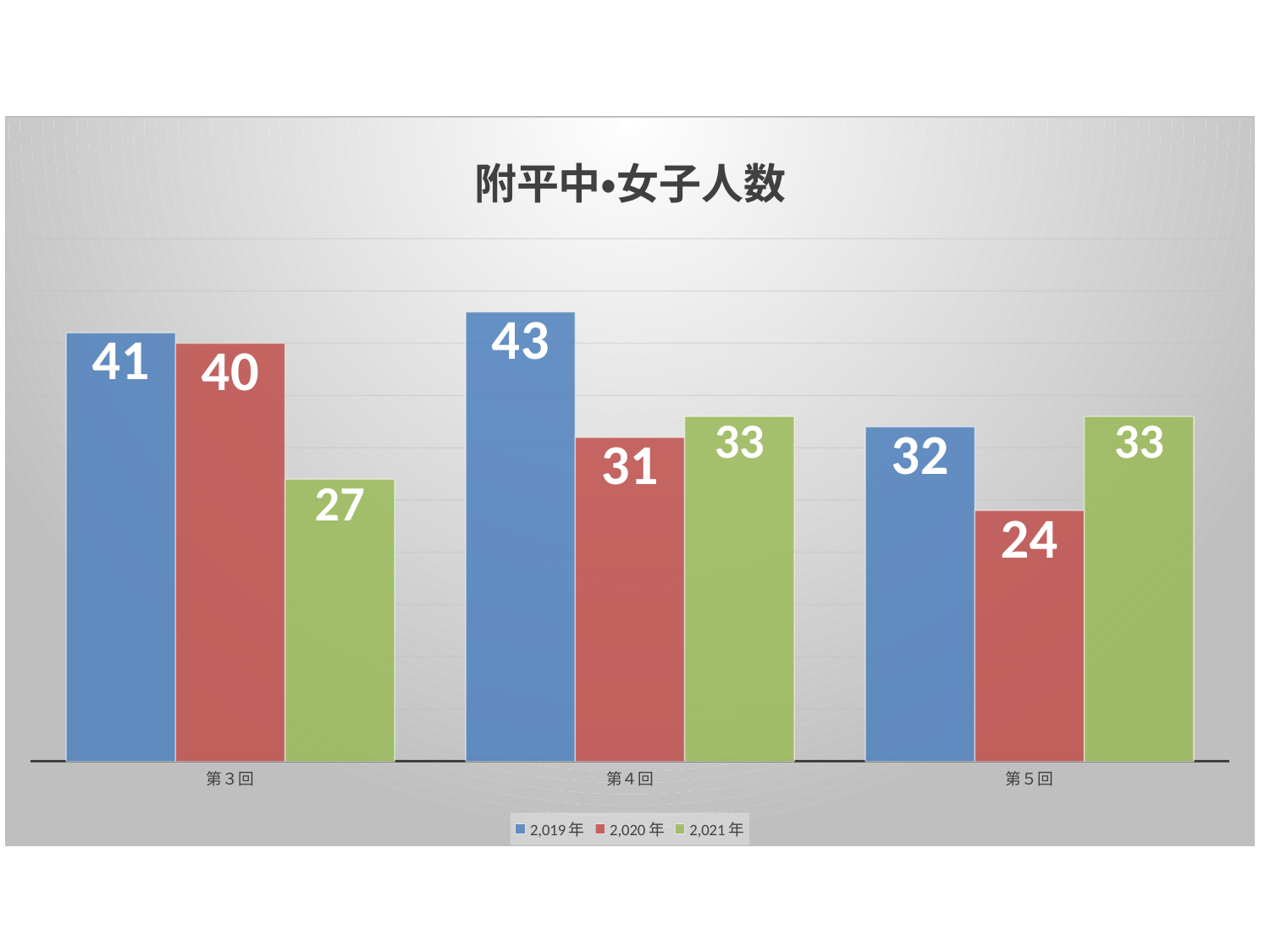
Which category has the highest value for 2,019 年? 第4回 Do the values for 2,020 年 rise or fall from 第3回 to 第5回? fall Which category has the lowest value for 2,020 年? 第5回 How many series does the legend list? 3 At 第5回, which is larger: the value for 2,019 年 or the value for 2,021 年? 2,021 年 What is the title of the chart? 附平中•女子人数 How many categories are shown on the x axis? 3 What is the difference between the 2,019 年 and 2,021 年 values at 第3回? 14 What is the value for 2,019 年 at 第3回? 41 What is the value for 2,021 年 at 第4回? 33 What kind of chart is this? bar chart What is the value for 2,020 年 at 第5回? 24